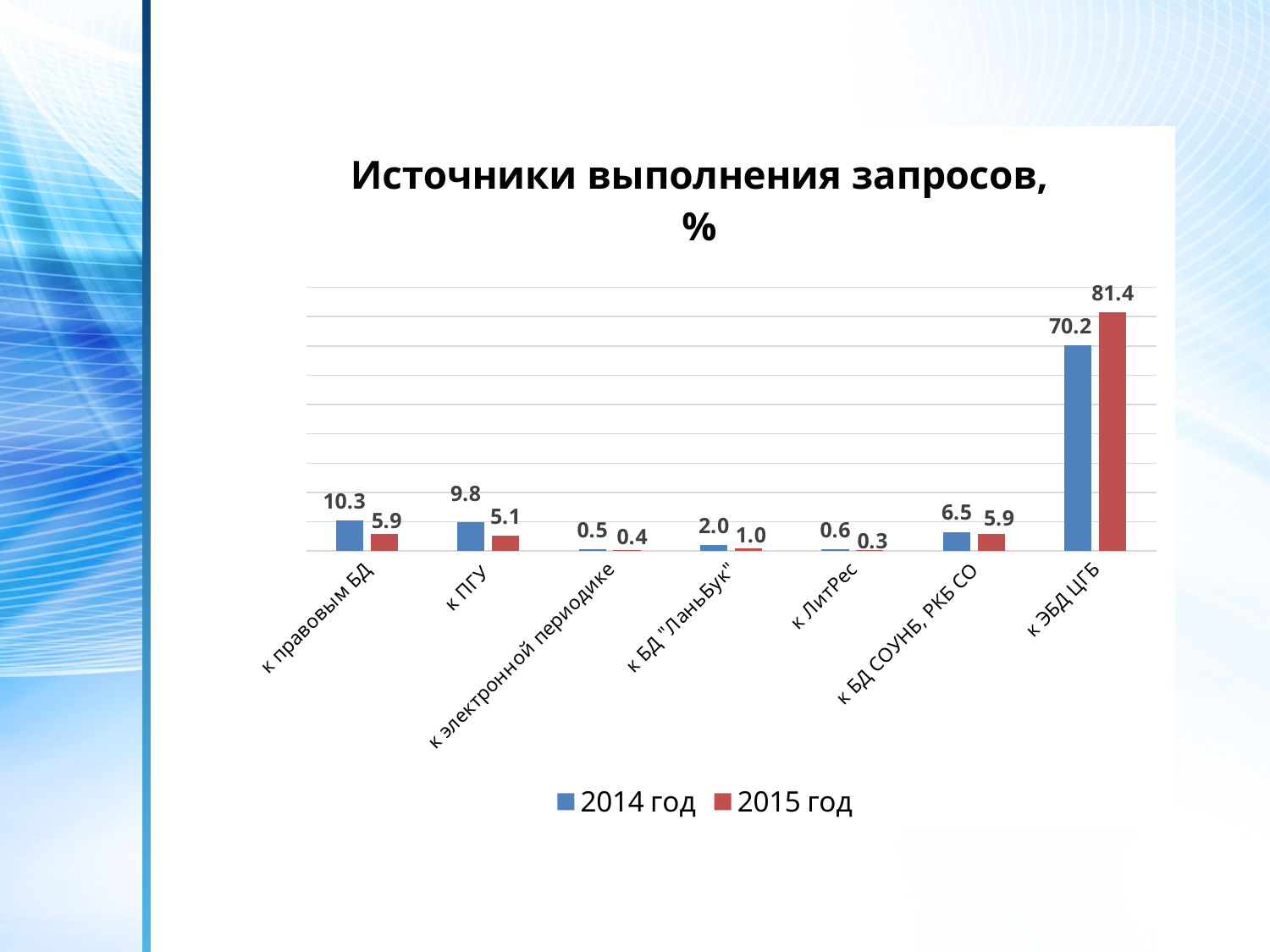
What is the value for 2015 год for к ЛитРес? 0.3 Which category has the highest value for 2015 год? к ЭБД ЦГБ How many series does the legend list? 2 What is the difference between the 2015 год and 2014 год values for к ЭБД ЦГБ? 11.2 What is the value for 2014 год for к ЭБД ЦГБ? 70.2 How many categories are shown on the x axis? 7 Which is larger for к БД "ЛаньБук": the 2014 год value or the 2015 год value? 2014 год Which category has the lowest value for 2015 год? к ЛитРес What is the value for 2015 год for к правовым БД? 5.9 What is the title of the chart? Источники выполнения запросов, % What is the value for 2014 год for к ПГУ? 9.8 What kind of chart is shown on the slide? bar chart